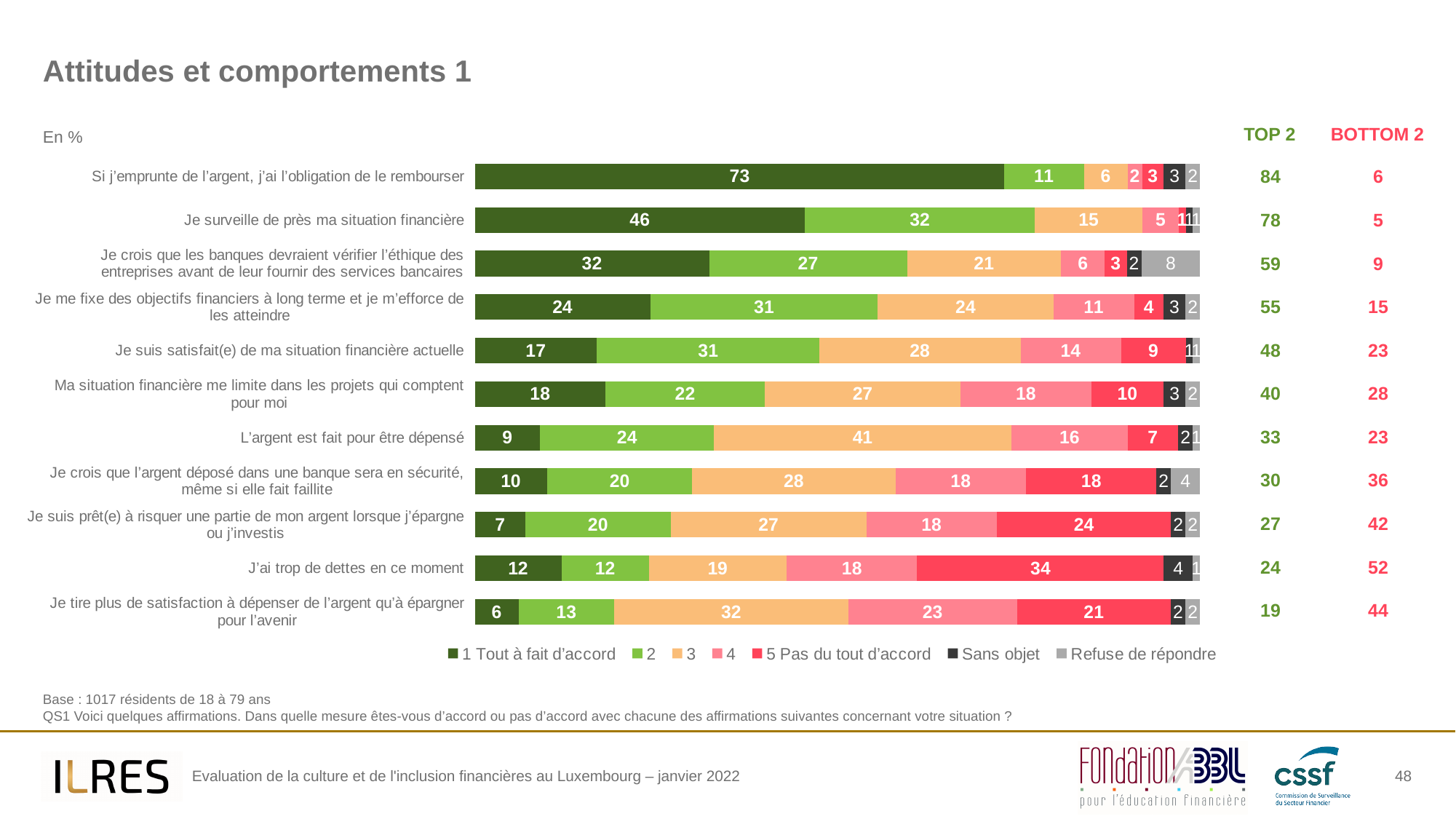
What is the value of '5 Pas du tout d'accord' for 'J'ai trop de dettes en ce moment'? 34 Which statement has the highest '1 Tout à fait d'accord' value? Si j'emprunte de l'argent, j'ai l'obligation de le rembourser What is the difference between the '2' values for 'Je surveille de près ma situation financière' and 'J'ai trop de dettes en ce moment'? 20 What is the value of '1 Tout à fait d'accord' for 'Si j'emprunte de l'argent, j'ai l'obligation de le rembourser'? 73 What is the value of series '3' for 'L'argent est fait pour être dépensé'? 41 Which statement has the lowest '1 Tout à fait d'accord' value? Je tire plus de satisfaction à dépenser de l'argent qu'à épargner pour l'avenir How many series does the legend list? 7 Which is larger: the '5 Pas du tout d'accord' value for 'Je suis prêt(e) à risquer une partie de mon argent lorsque j'épargne ou j'investis' or for 'Je crois que l'argent déposé dans une banque sera en sécurité, même si elle fait faillite'? Je suis prêt(e) à risquer une partie de mon argent lorsque j'épargne ou j'investis What type of chart is shown on the slide? Stacked bar chart How many statements (categories) are plotted in the chart? 11 What is the BOTTOM 2 value shown for 'J'ai trop de dettes en ce moment'? 52 What is the TOP 2 value shown for 'Je me fixe des objectifs financiers à long terme et je m'efforce de les atteindre'? 55